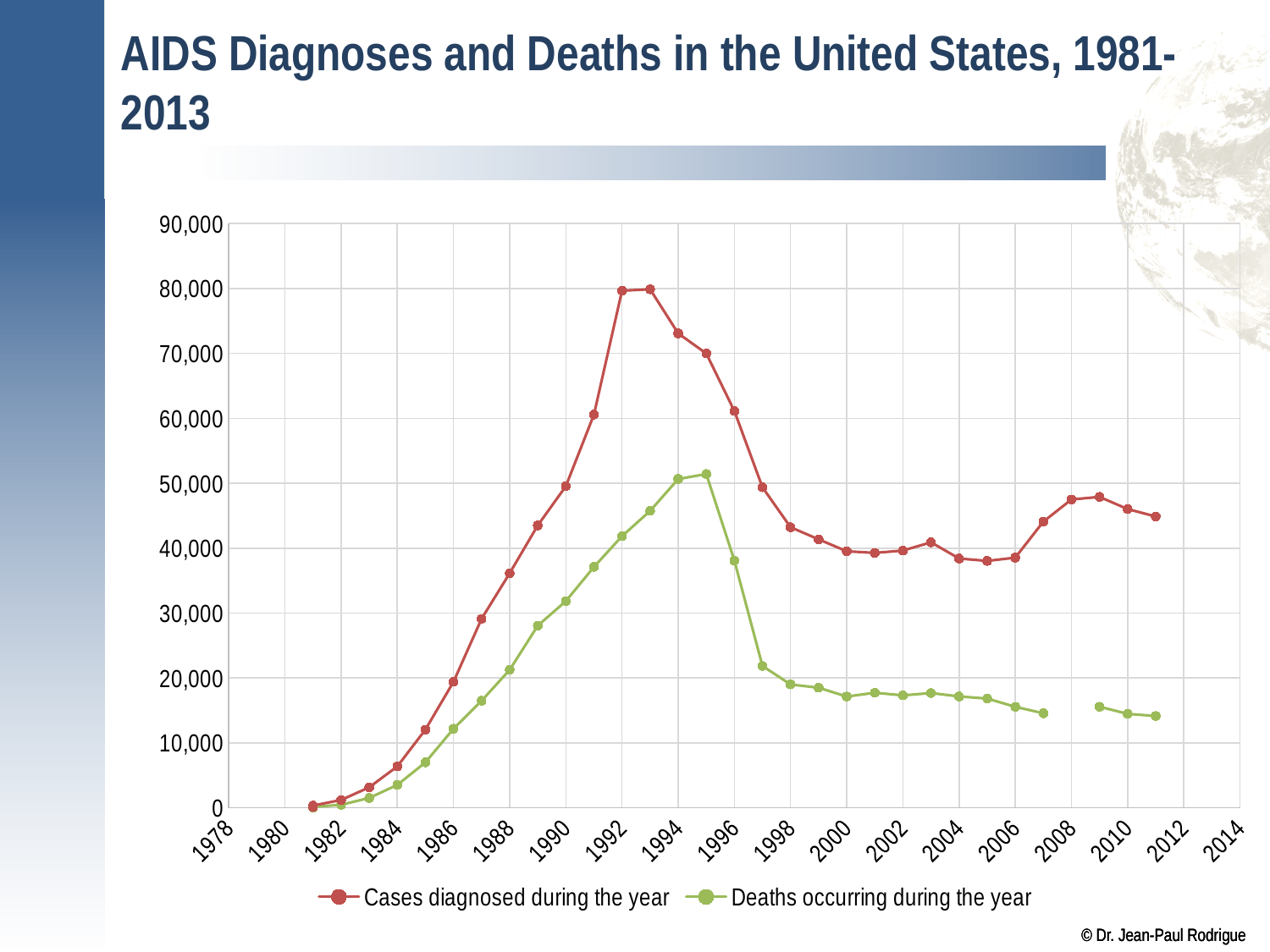
Is the value for deaths occurring in 2011 greater or less than 20,000? less In 1997, which is larger: cases diagnosed during the year or deaths occurring during the year? Cases diagnosed during the year Is the value for deaths occurring in 1998 greater or less than 30,000? less Is the value for cases diagnosed in 1992 greater or less than 70,000? greater How many series does the legend list? 2 What kind of chart is shown on the slide? Line chart What colour is the line for deaths occurring during the year? Green Do deaths occurring during the year rise or fall from 1995 to 1998? Fall Do cases diagnosed during the year rise or fall from 1981 to 1992? Rise What are the two series named in the legend? Cases diagnosed during the year; Deaths occurring during the year